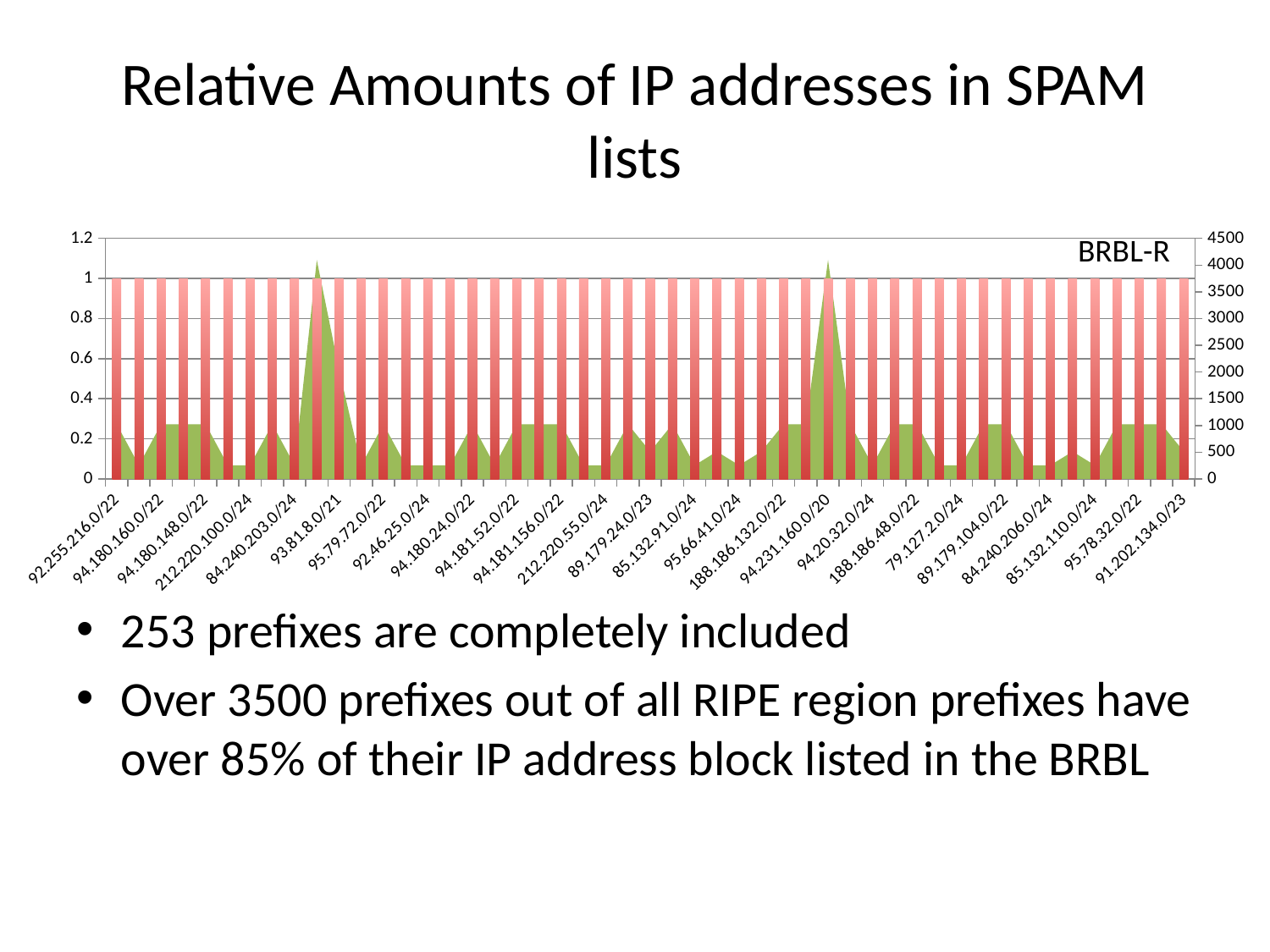
What is the maximum value shown on the right vertical axis? 4500 Is the green area value for 94.20.32.0/24 on the right axis greater or less than 1500? less What is the value of the red bar for 92.255.216.0/22 on the left axis? 1 Is the green area value for 94.231.160.0/20 on the right axis greater or less than 3500? greater Which has the larger green area value: 94.231.160.0/20 or 188.186.48.0/22? 94.231.160.0/20 Is the green area value for 95.79.72.0/22 on the right axis greater or less than 1500? less What kind of chart is shown on the slide? A combined bar and area chart Which has the larger green area value: 93.81.8.0/21 or 95.79.72.0/22? 93.81.8.0/21 What is the maximum value shown on the left vertical axis? 1.2 What is the value of the red bar for 91.202.134.0/23 on the left axis? 1